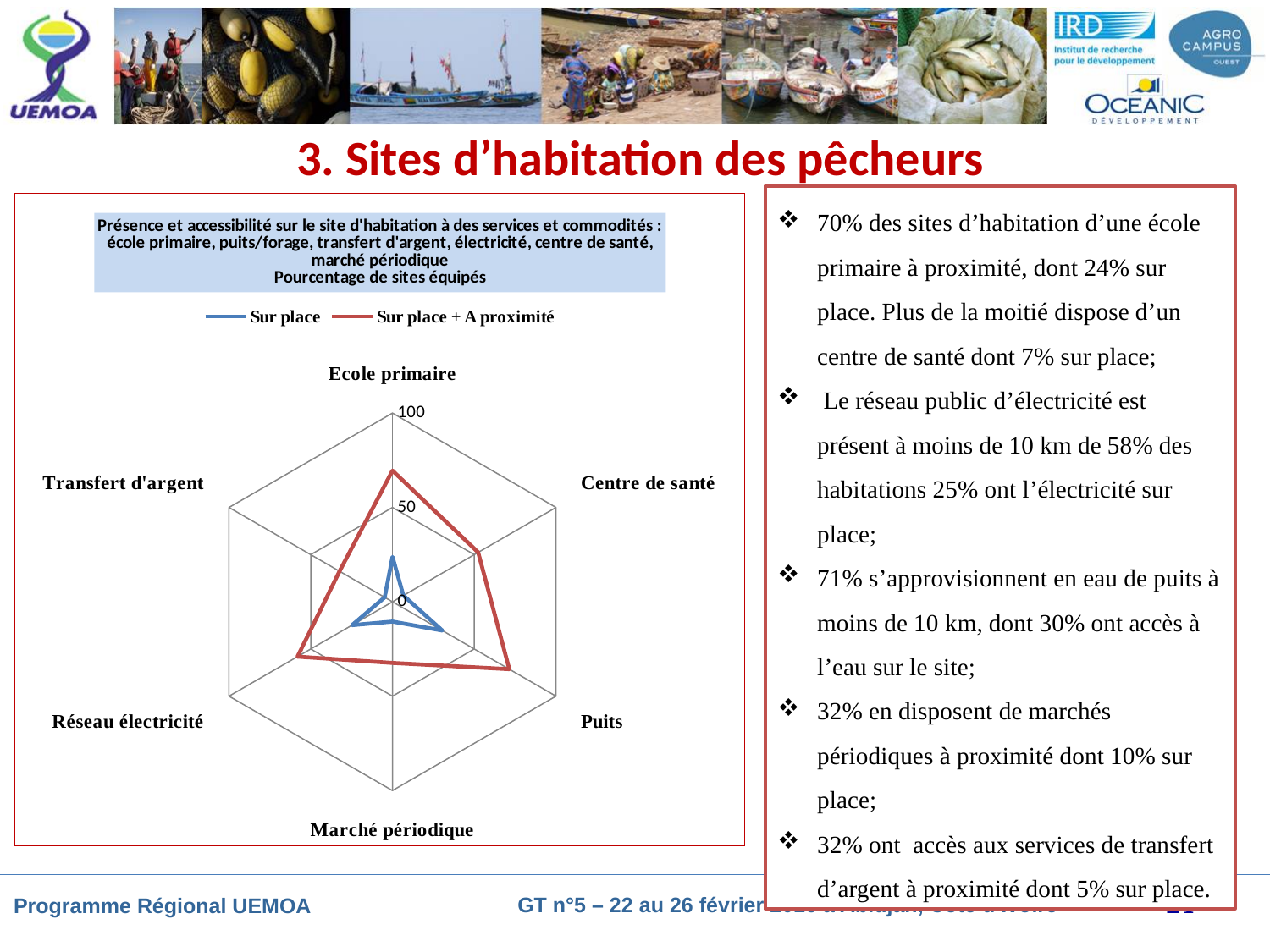
What kind of chart is shown on the slide? Radar chart How many series does the chart legend list? 2 For the 'Sur place' series, which is larger: Puits or Centre de santé? Puits Is the 'Sur place + A proximité' value for Marché périodique greater or less than 50? less For the 'Sur place + A proximité' series, which is larger: Puits or Centre de santé? Puits Is the 'Sur place + A proximité' value for Ecole primaire greater or less than 50? greater What are the two series named in the chart legend? Sur place; Sur place + A proximité What is the highest value shown on the radar chart's axis scale? 100 Is the 'Sur place' value for Puits greater or less than 50? less How many categories (axes) does the radar chart have? 6 For the 'Sur place + A proximité' series, which is larger: Ecole primaire or Marché périodique? Ecole primaire